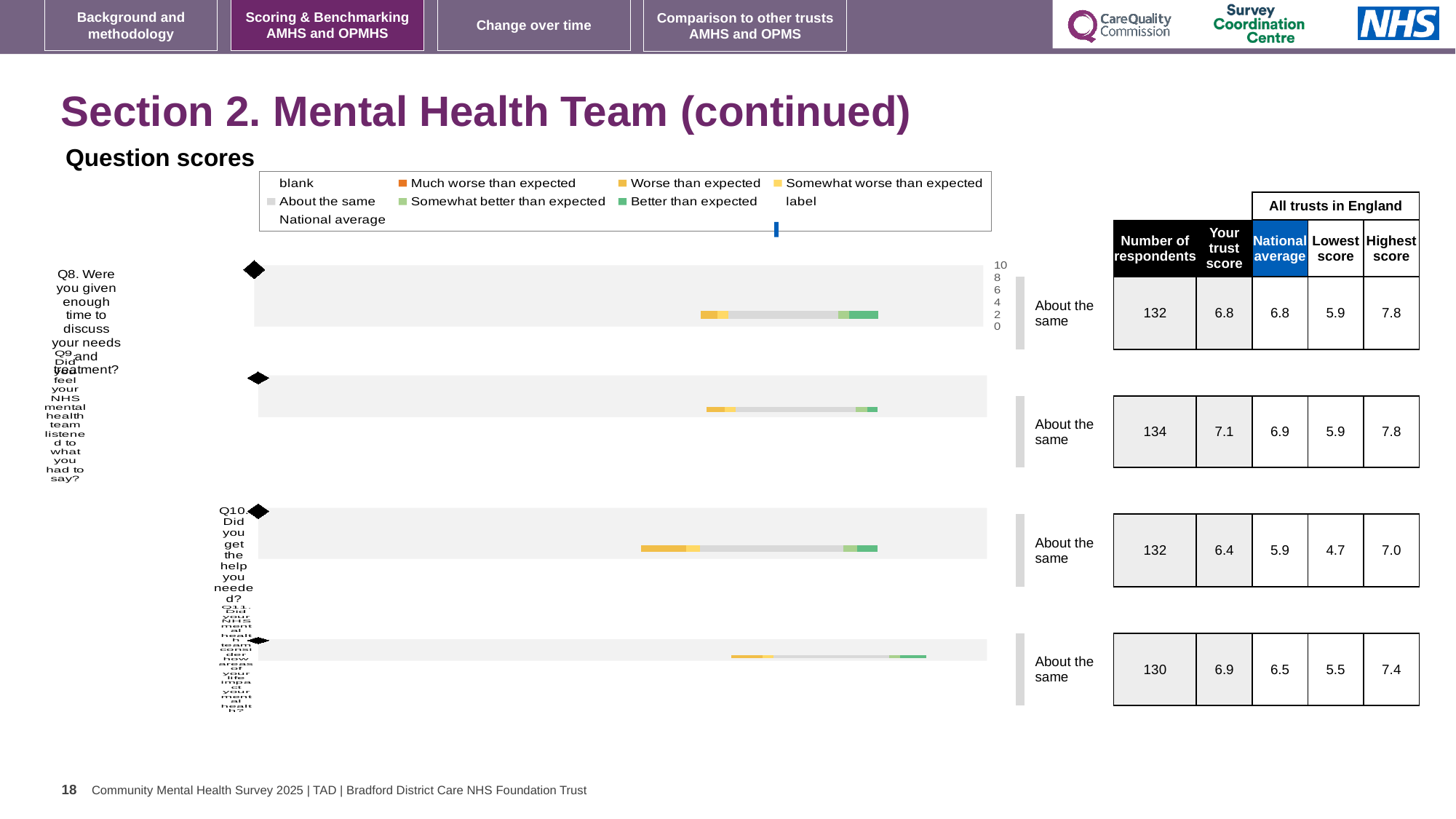
In the table next to the Q9 chart, what is the 'Your trust score' value? 7.1 Which question (Q8 to Q11) has the highest 'Your trust score' in the table? Q9 In the table next to the Q10 chart, what is the National average? 5.9 In the legend, which colour represents 'Much worse than expected'? orange In the table next to the Q8 chart, what is the 'Your trust score' value? 6.8 How many entries does the legend above the charts list? 9 In the legend, which colour represents 'About the same'? grey How many question charts (Q8 to Q11) are shown on the slide? 4 What category label is shown to the right of the Q8 chart? About the same What is the difference between the Highest score and Lowest score for Q10 in the table? 2.3 In the table next to the Q11 chart, how many respondents are listed? 130 What kind of chart is used to show the question scores for Q8 to Q11? bar chart